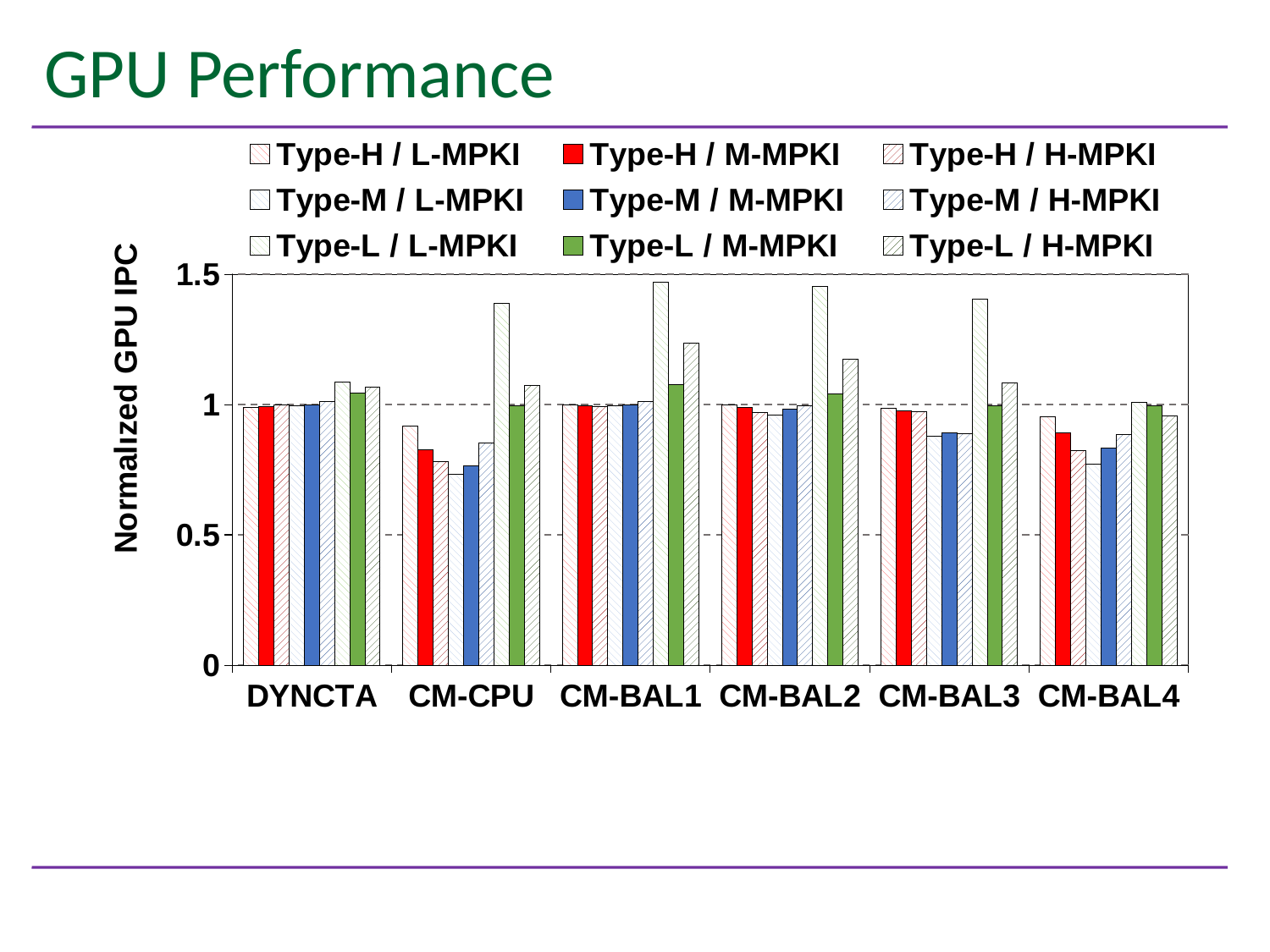
Is the value for Type-M / M-MPKI in CM-CPU greater or less than 1? less How many series does the legend list? 9 For the Type-H / M-MPKI series, which is larger: the value for DYNCTA or the value for CM-CPU? DYNCTA What is the label of the y axis? Normalized GPU IPC Which colour is used for the Type-H / M-MPKI series? red What kind of chart is shown on the slide? bar chart Within the CM-CPU group, which series has the highest value? Type-L / L-MPKI Is the value for Type-L / L-MPKI in CM-BAL3 greater or less than 1? greater Is the value for Type-L / L-MPKI in CM-BAL1 greater or less than 1? greater Within the CM-BAL1 group, which series has the highest value? Type-L / L-MPKI How many categories are shown on the x axis of the chart? 6